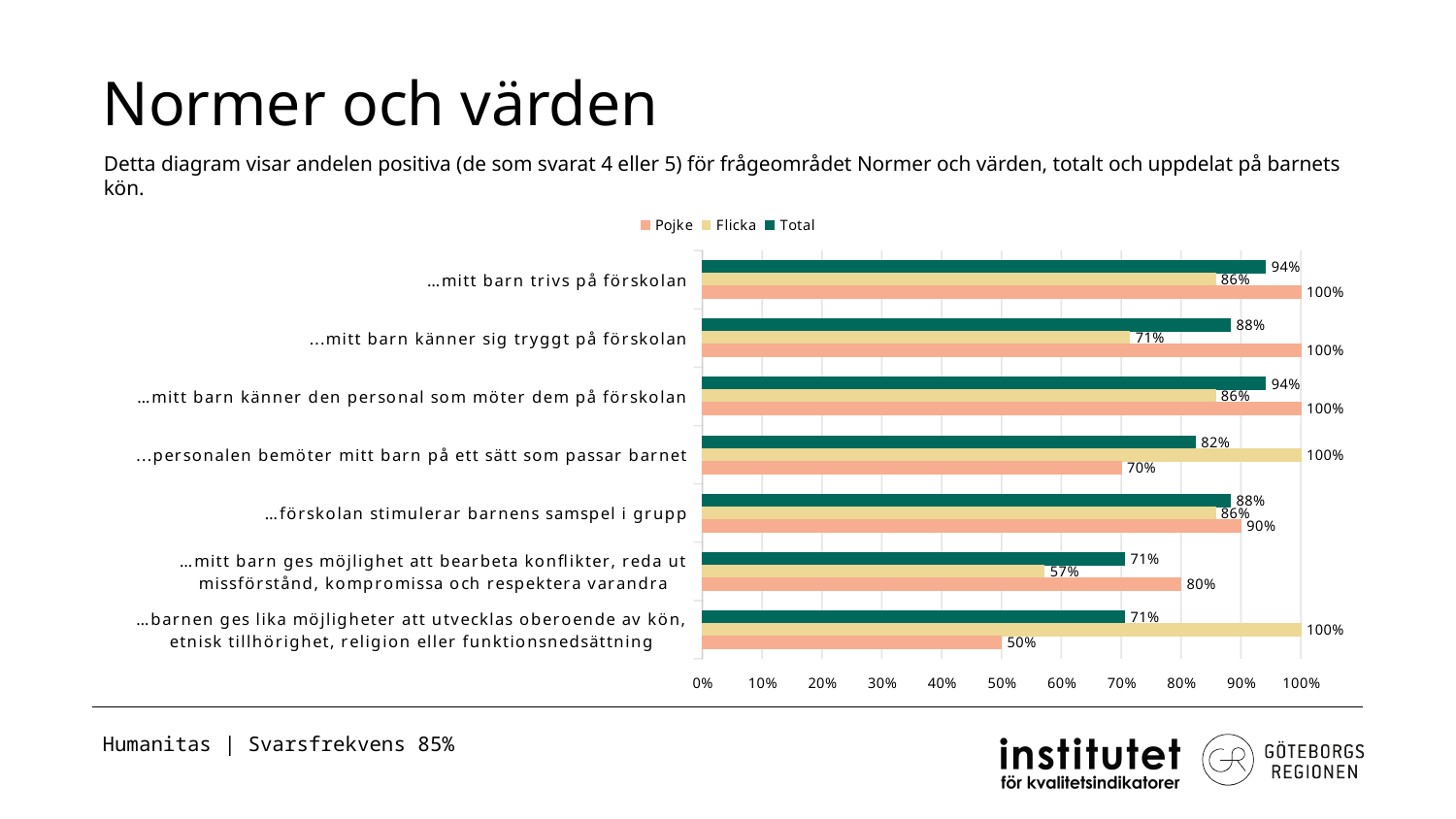
What is the difference between the Pojke and Flicka values for "…mitt barn ges möjlighet att bearbeta konflikter, reda ut missförstånd, kompromissa och respektera varandra"? 23% Which series is shown in dark green in the legend? Total What is the Total value for "…mitt barn trivs på förskolan"? 94% How many series does the legend list? 3 What is the Flicka value for "…mitt barn känner sig tryggt på förskolan"? 71% What is the Pojke value for "…barnen ges lika möjligheter att utvecklas oberoende av kön, etnisk tillhörighet, religion eller funktionsnedsättning"? 50% What is the Pojke value for "…personalen bemöter mitt barn på ett sätt som passar barnet"? 70% How many categories are shown on the chart? 7 What is the Total value for "…mitt barn ges möjlighet att bearbeta konflikter, reda ut missförstånd, kompromissa och respektera varandra"? 71% For "…förskolan stimulerar barnens samspel i grupp", which is larger, the Pojke value or the Flicka value? Pojke What kind of chart is shown on the slide? Bar chart Which category has the lowest Flicka value? …mitt barn ges möjlighet att bearbeta konflikter, reda ut missförstånd, kompromissa och respektera varandra